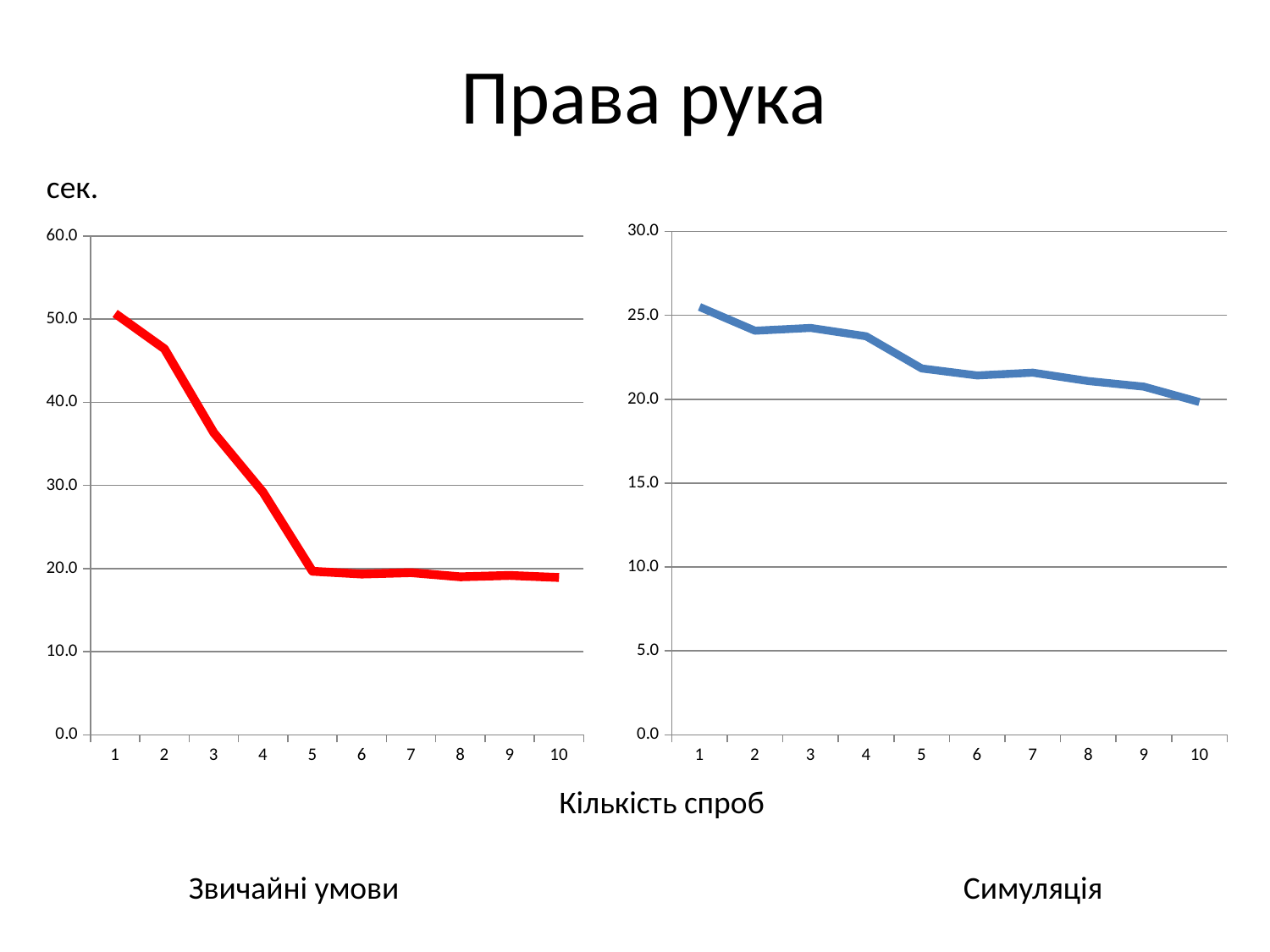
In the left chart (Звичайні умови), is the value for trial 5 greater or less than 30.0? less In the right chart (Симуляція), do the values rise or fall from trial 1 to trial 10? fall In the left chart (Звичайні умови), which trial has the highest value? 1 What kind of chart is the right chart (Симуляція)? line chart How many trials (points) are plotted on the x axis of the right chart (Симуляція)? 10 In the left chart (Звичайні умови), is the value for trial 3 greater or less than 30.0? greater What kind of chart is the left chart (Звичайні умови)? line chart In the right chart (Симуляція), is the value for trial 10 greater or less than 25.0? less In the right chart (Симуляція), which is larger, the value for trial 2 or the value for trial 5? trial 2 In the left chart (Звичайні умови), do the values rise or fall from trial 1 to trial 10? fall How many trials (points) are plotted on the x axis of the left chart (Звичайні умови)? 10 In the right chart (Симуляція), which trial has the highest value? 1